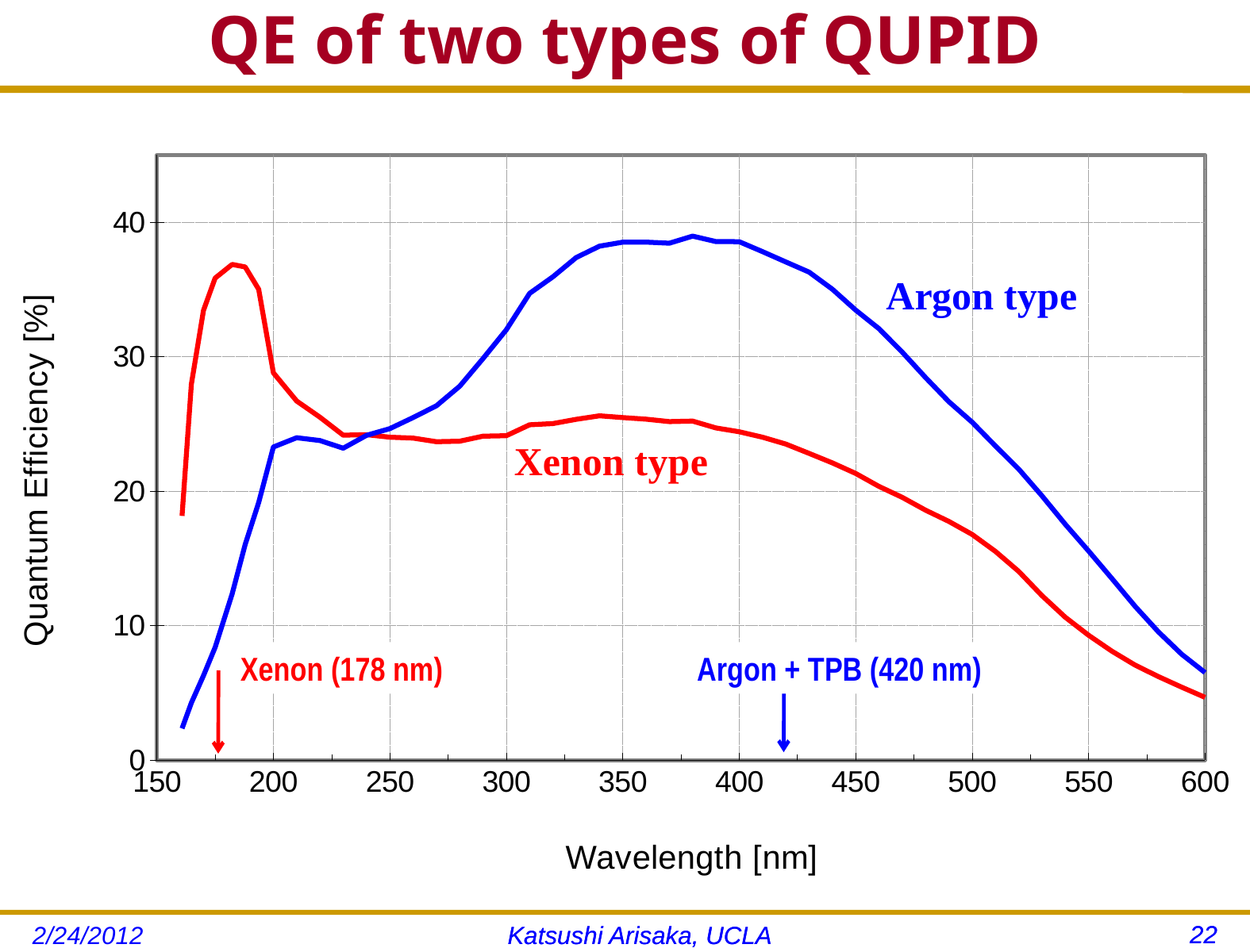
What is the label of the x axis? Wavelength [nm] Does the Argon type quantum efficiency rise or fall between 400 nm and 600 nm? fall At 400 nm, which type has the higher quantum efficiency, Argon type or Xenon type? Argon type What kind of chart is shown on the slide? line chart How many series (curves) are plotted on the chart? 2 Is the quantum efficiency of the Argon type at 600 nm greater or less than 10%? less Is the quantum efficiency of the Xenon type at 400 nm greater or less than 30%? less What is the title of the chart on the slide? QE of two types of QUPID Is the quantum efficiency of the Argon type at 500 nm greater or less than 20%? greater At 180 nm, which type has the higher quantum efficiency, Argon type or Xenon type? Xenon type